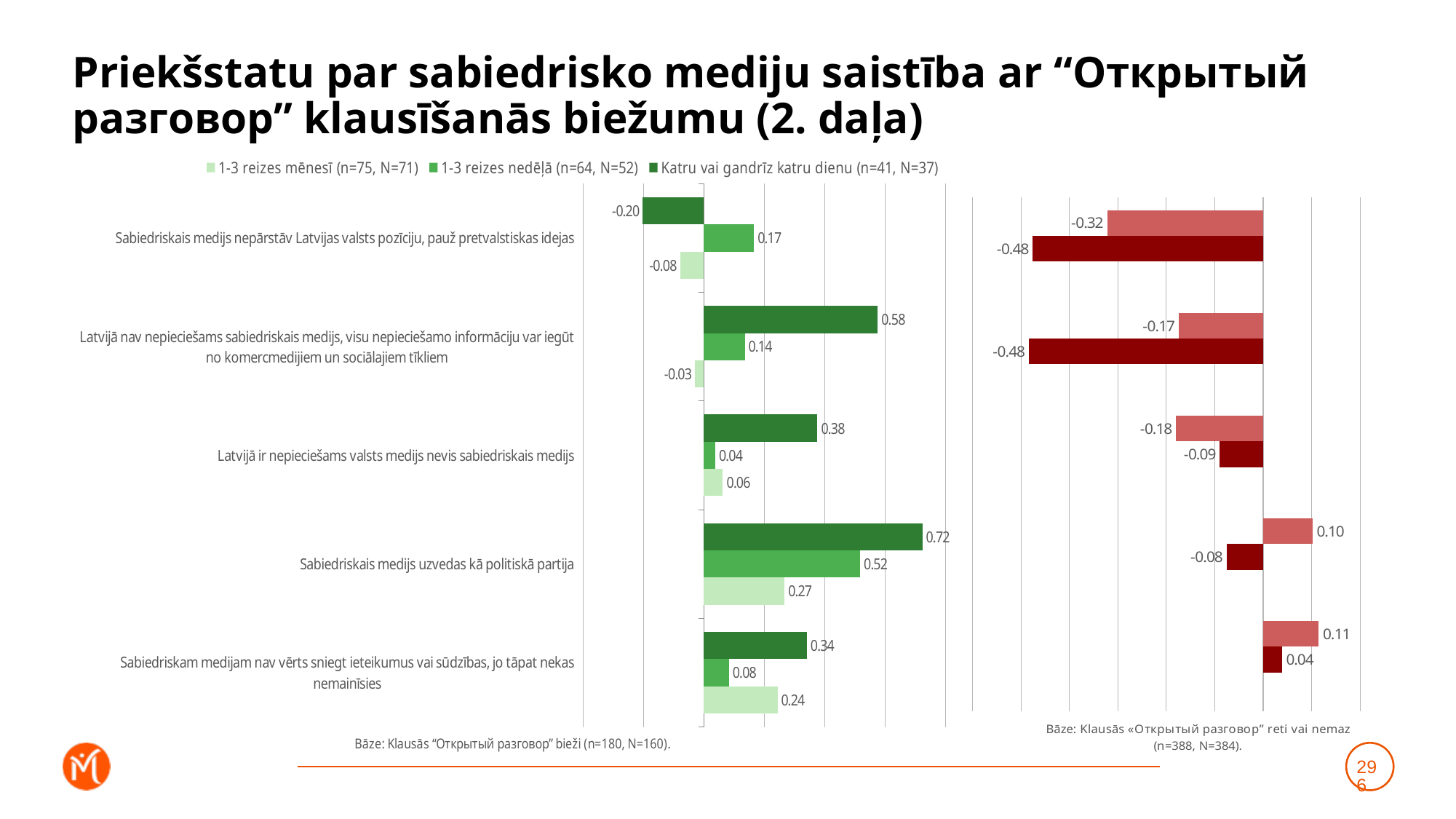
What kind of chart is the left (green) chart? Bar chart How many series does the legend of the left (green) chart list? 3 On the right (red) chart, what is the value of the lighter red bar for 'Sabiedriskam medijam nav vērts sniegt ieteikumus vai sūdzības, jo tāpat nekas nemainīsies'? 0.11 On the left (green) chart, which statement has the lowest value for 'Katru vai gandrīz katru dienu'? Sabiedriskais medijs nepārstāv Latvijas valsts pozīciju, pauž pretvalstiskas idejas On the left (green) chart, what is the difference between the 'Katru vai gandrīz katru dienu' and '1-3 reizes nedēļā' values for 'Sabiedriskais medijs uzvedas kā politiskā partija'? 0.20 How many statements (categories) are shown on the left (green) chart? 5 On the left (green) chart, what is the value for '1-3 reizes mēnesī' for 'Sabiedriskam medijam nav vērts sniegt ieteikumus vai sūdzības, jo tāpat nekas nemainīsies'? 0.24 On the left (green) chart, what is the value for 'Katru vai gandrīz katru dienu' for 'Sabiedriskais medijs uzvedas kā politiskā partija'? 0.72 On the left (green) chart, which statement has the highest value for 'Katru vai gandrīz katru dienu'? Sabiedriskais medijs uzvedas kā politiskā partija On the left (green) chart, for 'Latvijā ir nepieciešams valsts medijs nevis sabiedriskais medijs', which is larger: the '1-3 reizes mēnesī' value or the '1-3 reizes nedēļā' value? 1-3 reizes mēnesī On the left (green) chart, what is the value for '1-3 reizes nedēļā' for 'Latvijā nav nepieciešams sabiedriskais medijs, visu nepieciešamo informāciju var iegūt no komercmedijiem un sociālajiem tīkliem'? 0.14 On the right (red) chart, what is the value of the dark red bar for 'Sabiedriskais medijs nepārstāv Latvijas valsts pozīciju, pauž pretvalstiskas idejas'? -0.48